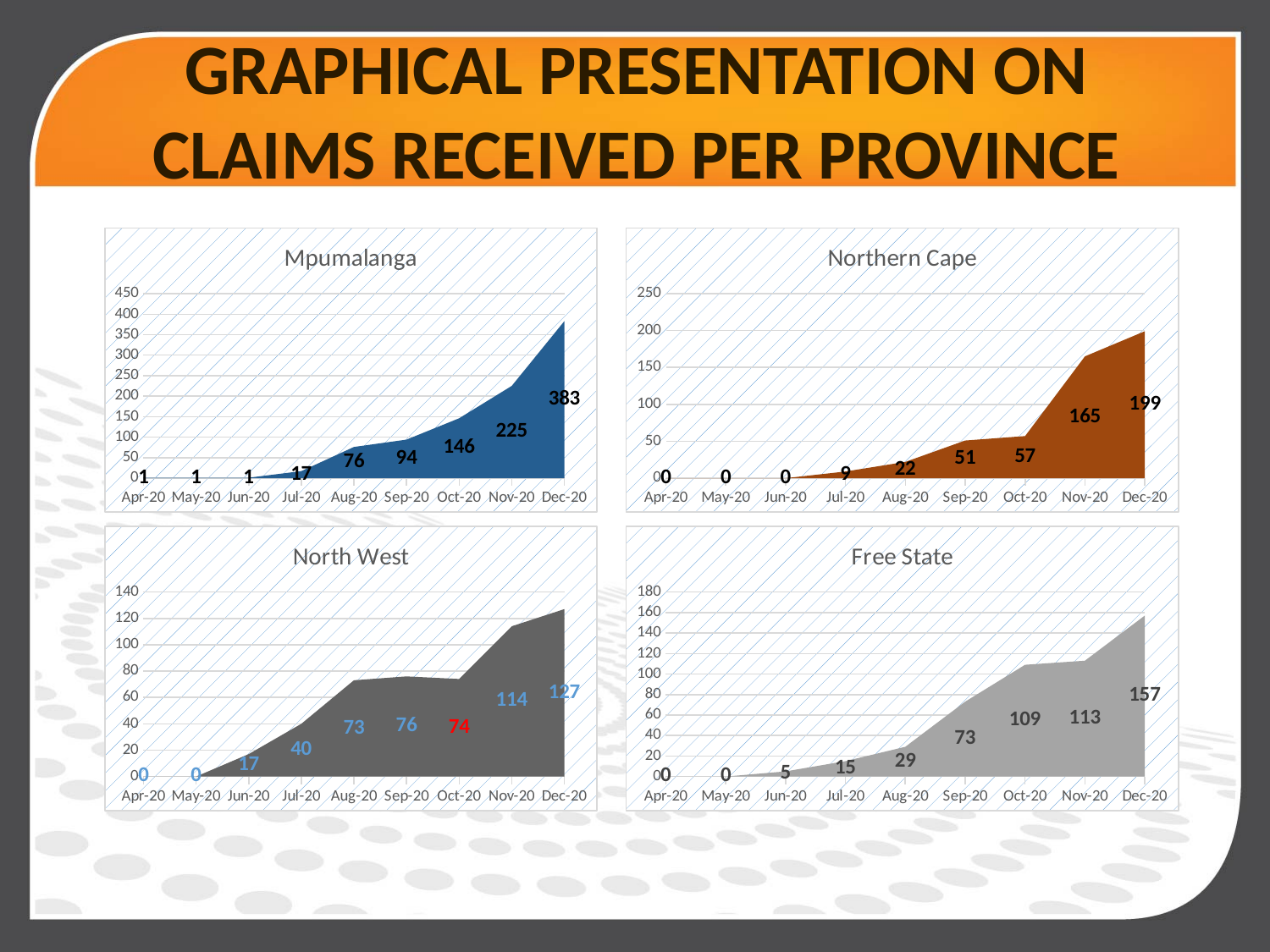
In the North West chart, what is the value for Sep-20? 76 In the Free State chart, what is the value for Oct-20? 109 How many months are plotted on the x axis of the Free State chart? 9 In the Northern Cape chart, what is the difference between the Nov-20 and Oct-20 values? 108 In the Free State chart, do the values generally rise or fall from Apr-20 to Dec-20? Rise What kind of chart is the Northern Cape chart? Area chart In the Mpumalanga chart, what is the value for Dec-20? 383 In the North West chart, which is larger, the value for Sep-20 or the value for Oct-20? Sep-20 In the Mpumalanga chart, what is the difference between the Dec-20 and Nov-20 values? 158 In the Mpumalanga chart, which month has the highest value? Dec-20 In the Free State chart, which month has the lowest non-zero value? Jun-20 In the Northern Cape chart, what is the value for Nov-20? 165